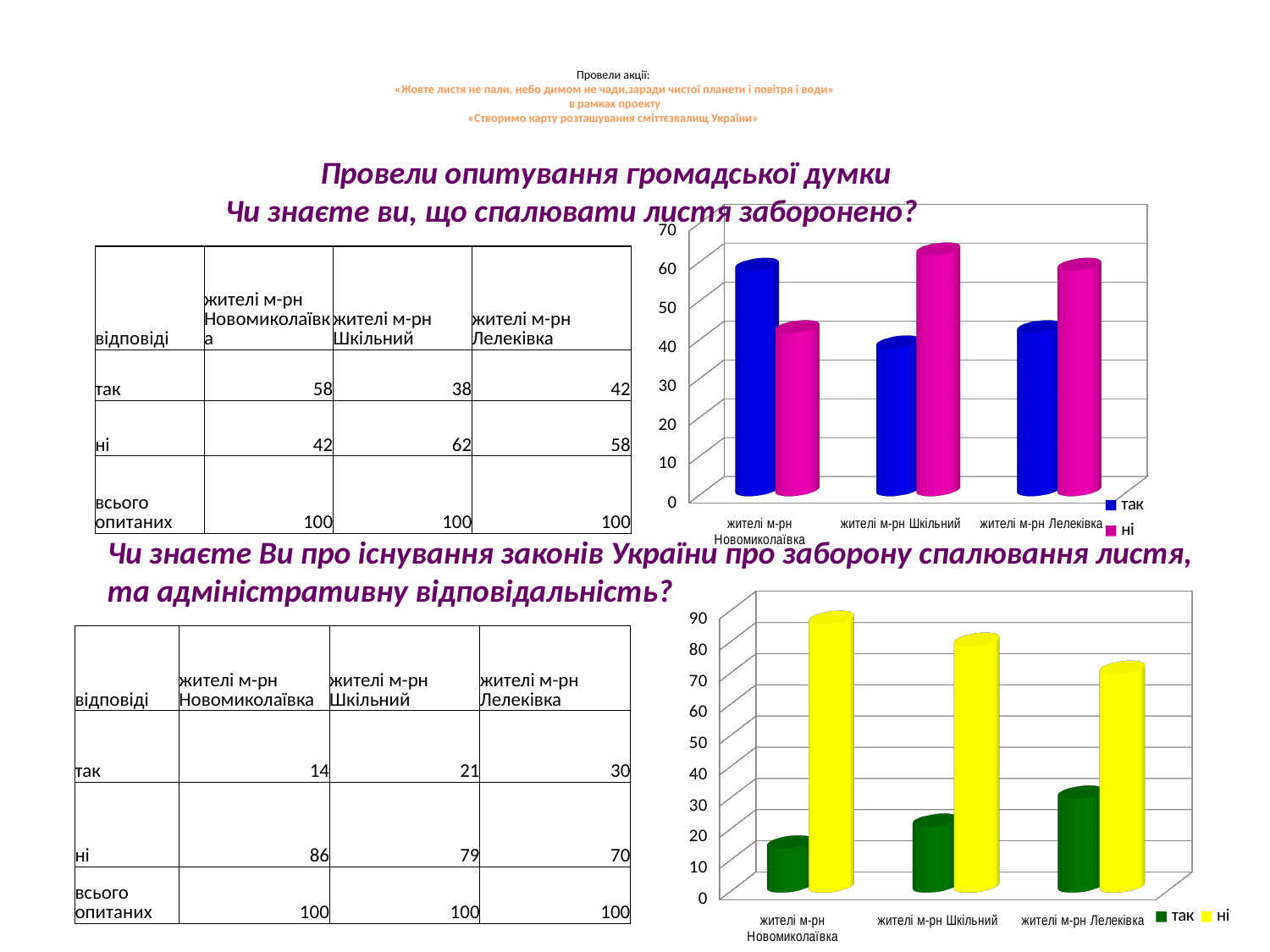
In the bottom chart, is the value of 'ні' for жителі м-рн Новомиколаївка greater or less than 80? greater In the bottom chart, which colour represents the series 'ні'? yellow In the bottom chart, do the values of the series 'так' rise or fall from left to right along the x axis? rise In the top chart, which category has the highest value for the series 'ні'? жителі м-рн Шкільний In the top chart, what kind of chart is shown? bar chart In the top chart, how many categories are shown on the x axis? 3 In the top chart, which is larger for жителі м-рн Лелеківка: 'так' or 'ні'? ні In the bottom chart, which category has the lowest value for the series 'ні'? жителі м-рн Лелеківка In the top chart, how many series does the legend list? 2 In the bottom chart, which category has the highest value for the series 'так'? жителі м-рн Лелеківка In the top chart, which category has the lowest value for the series 'так'? жителі м-рн Шкільний In the top chart, is the value of 'так' for жителі м-рн Новомиколаївка greater or less than 50? greater